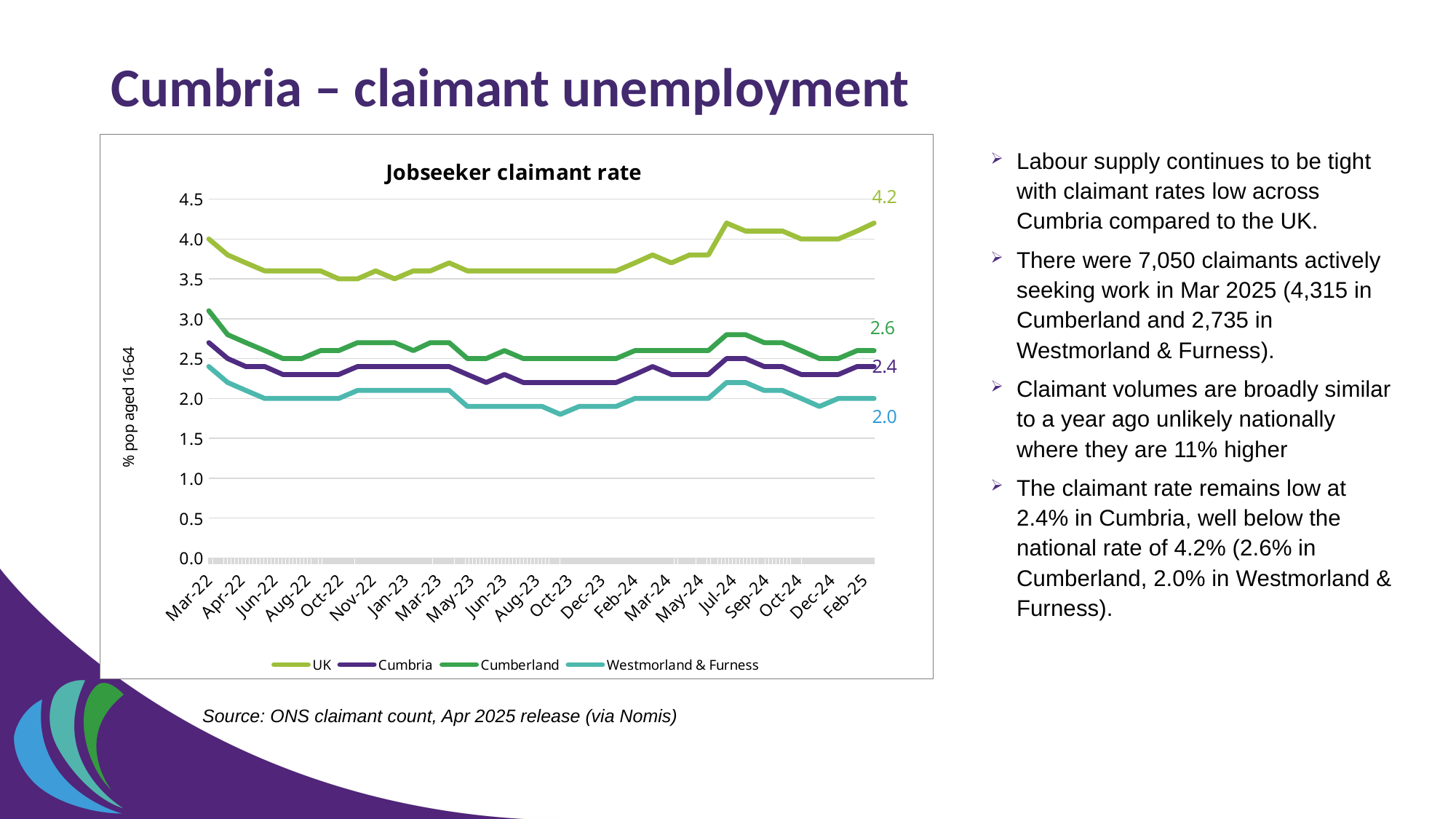
What is the difference between the latest labelled UK value and the latest labelled Cumbria value? 1.8 What is the label on the vertical axis of the Jobseeker claimant rate chart? % pop aged 16-64 Is the value for the UK series in Mar-22 greater or less than 3.5? greater What is the latest labelled value for the UK series in the Jobseeker claimant rate chart? 4.2 Which series has the lowest value at the end of the Jobseeker claimant rate chart? Westmorland & Furness What kind of chart is shown on the slide? Line chart What is the latest labelled value for the Westmorland & Furness series in the Jobseeker claimant rate chart? 2.0 What is the latest labelled value for the Cumberland series in the Jobseeker claimant rate chart? 2.6 How many series does the legend of the Jobseeker claimant rate chart list? 4 What is the difference between the latest labelled Cumberland value and the latest labelled Westmorland & Furness value? 0.6 Is the value for the Westmorland & Furness series in Oct-23 greater or less than 2.0? less Which series has the highest value at the end of the Jobseeker claimant rate chart? UK